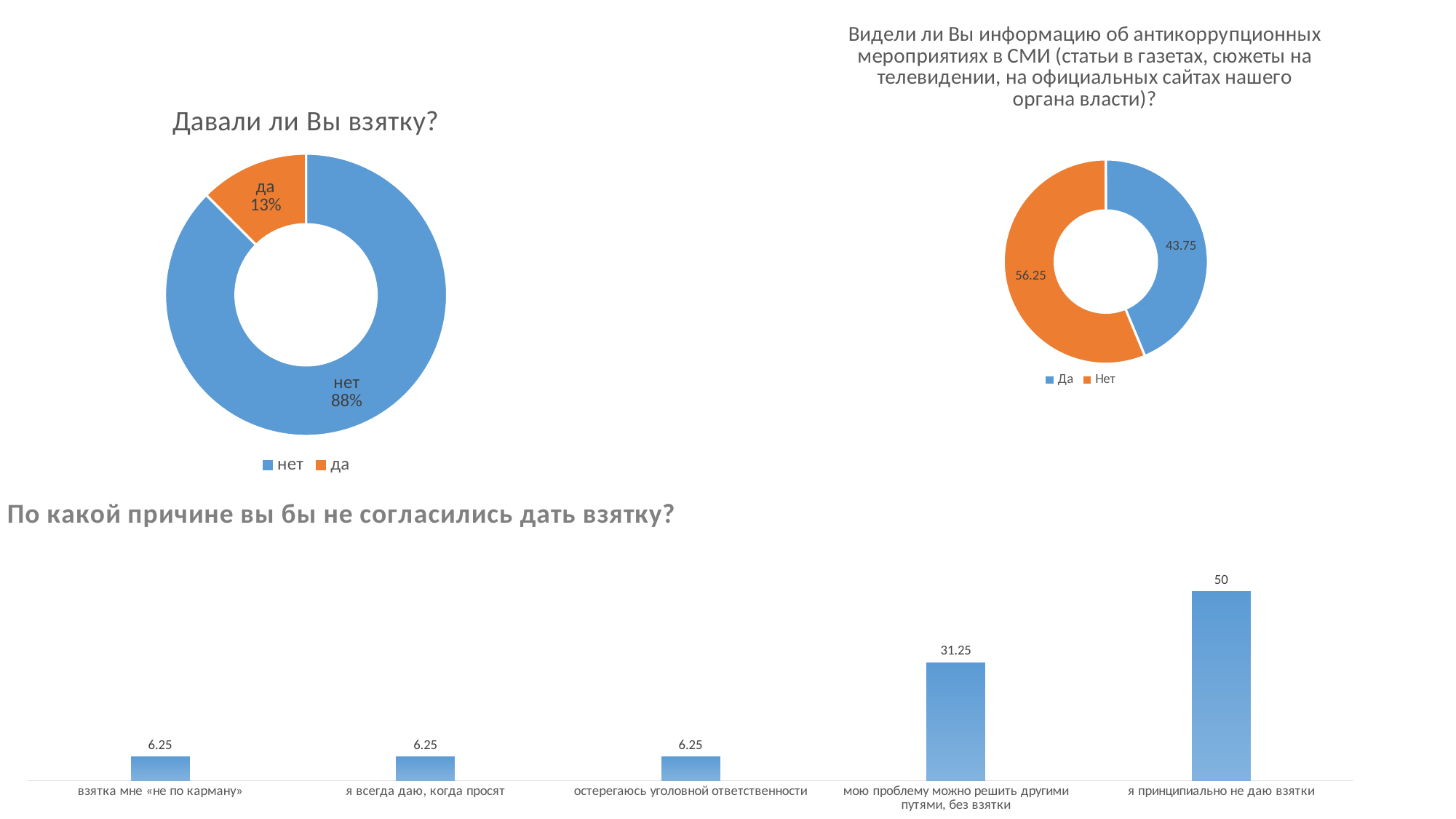
In the bottom chart "По какой причине вы бы не согласились дать взятку?", what is the value for "мою проблему можно решить другими путями, без взятки"? 31.25 In the bottom chart "По какой причине вы бы не согласились дать взятку?", what is the value for "я принципиально не даю взятки"? 50 What kind of chart is the one titled "Давали ли Вы взятку?"? Doughnut chart In the top-right chart about seeing anti-corruption information in the media, what is the value for "Нет"? 56.25 In the chart titled "Давали ли Вы взятку?", what percentage answered "да"? 13% In the bottom chart "По какой причине вы бы не согласились дать взятку?", which category has the highest value? я принципиально не даю взятки In the top-right chart about seeing anti-corruption information in the media, what is the value for "Да"? 43.75 In the bottom chart "По какой причине вы бы не согласились дать взятку?", what is the difference between "я принципиально не даю взятки" and "остерегаюсь уголовной ответственности"? 43.75 In the top-right chart about seeing anti-corruption information in the media, what is the difference between the "Нет" and "Да" values? 12.5 In the chart titled "Давали ли Вы взятку?", what percentage answered "нет"? 88% How many categories are shown in the bottom chart "По какой причине вы бы не согласились дать взятку?"? 5 In the top-right chart about seeing anti-corruption information in the media, which answer has the larger share, "Да" or "Нет"? Нет